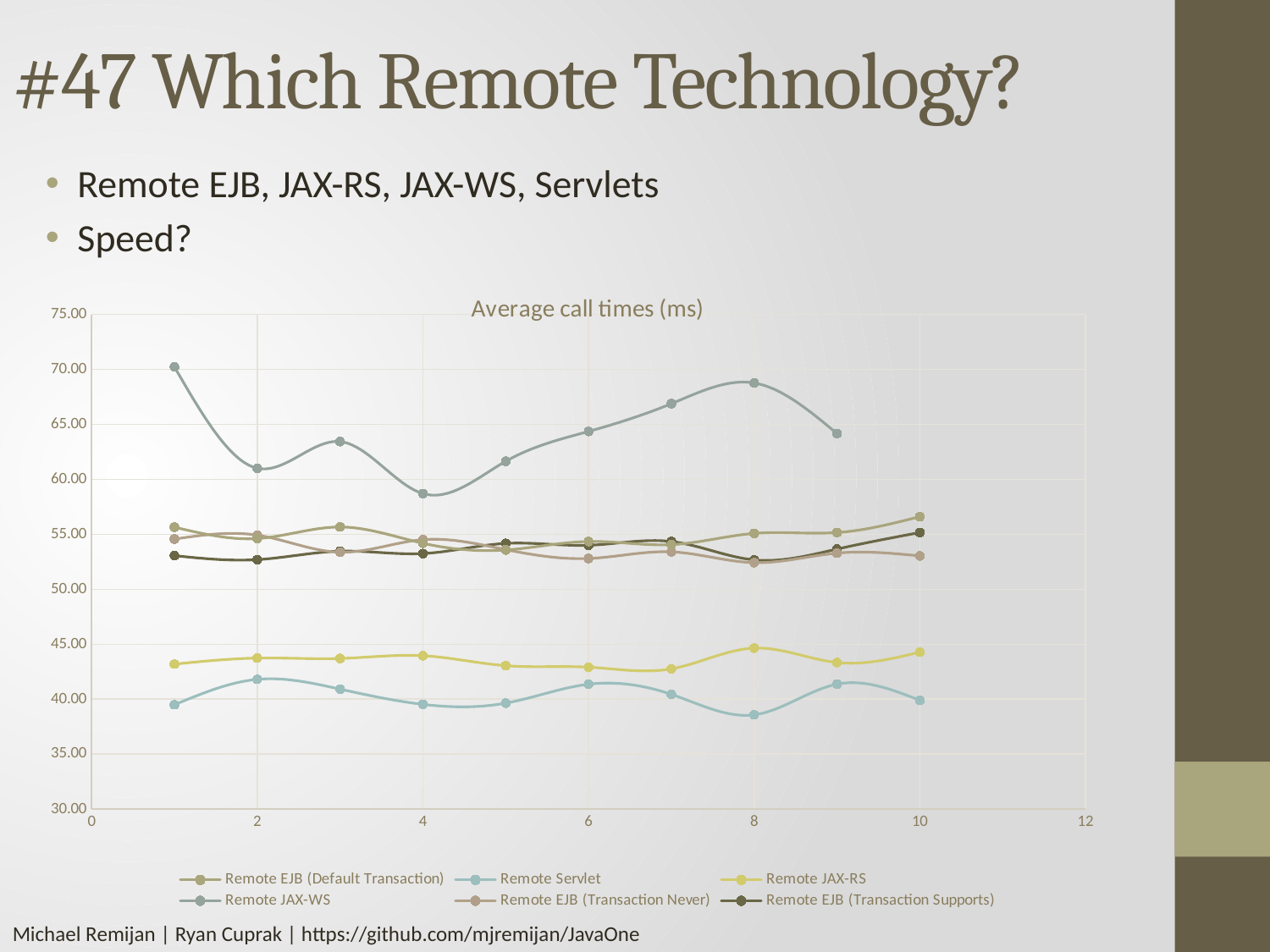
Is the value for Remote JAX-RS at x = 1 greater or less than 45.00? less What is the title of the chart? Average call times (ms) What kind of chart is shown on the slide? line chart Is the value for Remote JAX-WS at x = 4 greater or less than 60.00? less Is the value for Remote JAX-WS at x = 1 greater or less than 65.00? greater How many data points are plotted for the Remote Servlet series? 10 Does the Remote JAX-WS line rise or fall from x = 1 to x = 2? fall Which series has the lowest values overall in the chart? Remote Servlet Which series has the highest values overall in the chart? Remote JAX-WS How many series does the chart legend list? 6 At x = 5, which is larger: Remote JAX-RS or Remote Servlet? Remote JAX-RS